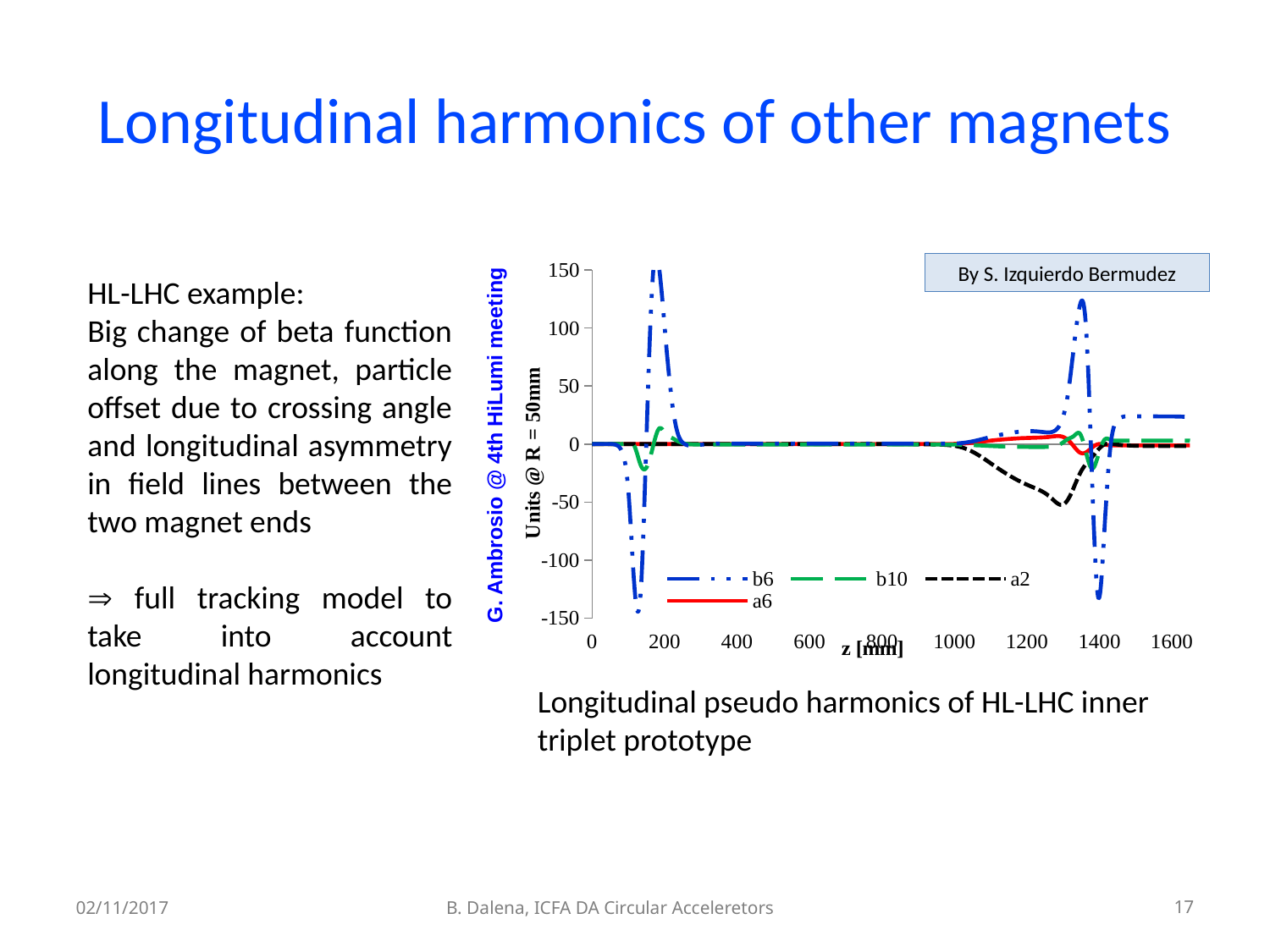
What is the label of the x axis of the chart? z [mm] Which series reaches the lowest value on the chart? b6 Is the value of the a2 series at z = 1200 mm greater or less than 0? less Which series are listed in the chart legend? b6, b10, a2, a6 Is the value of the b6 series at z = 1600 mm greater or less than 0? greater Which series reaches the highest value on the chart? b6 What kind of chart is shown on the slide? line chart Is the peak value of the b6 series near z = 200 mm greater or less than 100? greater What is the largest tick value shown on the x axis of the chart? 1600 How many series does the chart legend list? 4